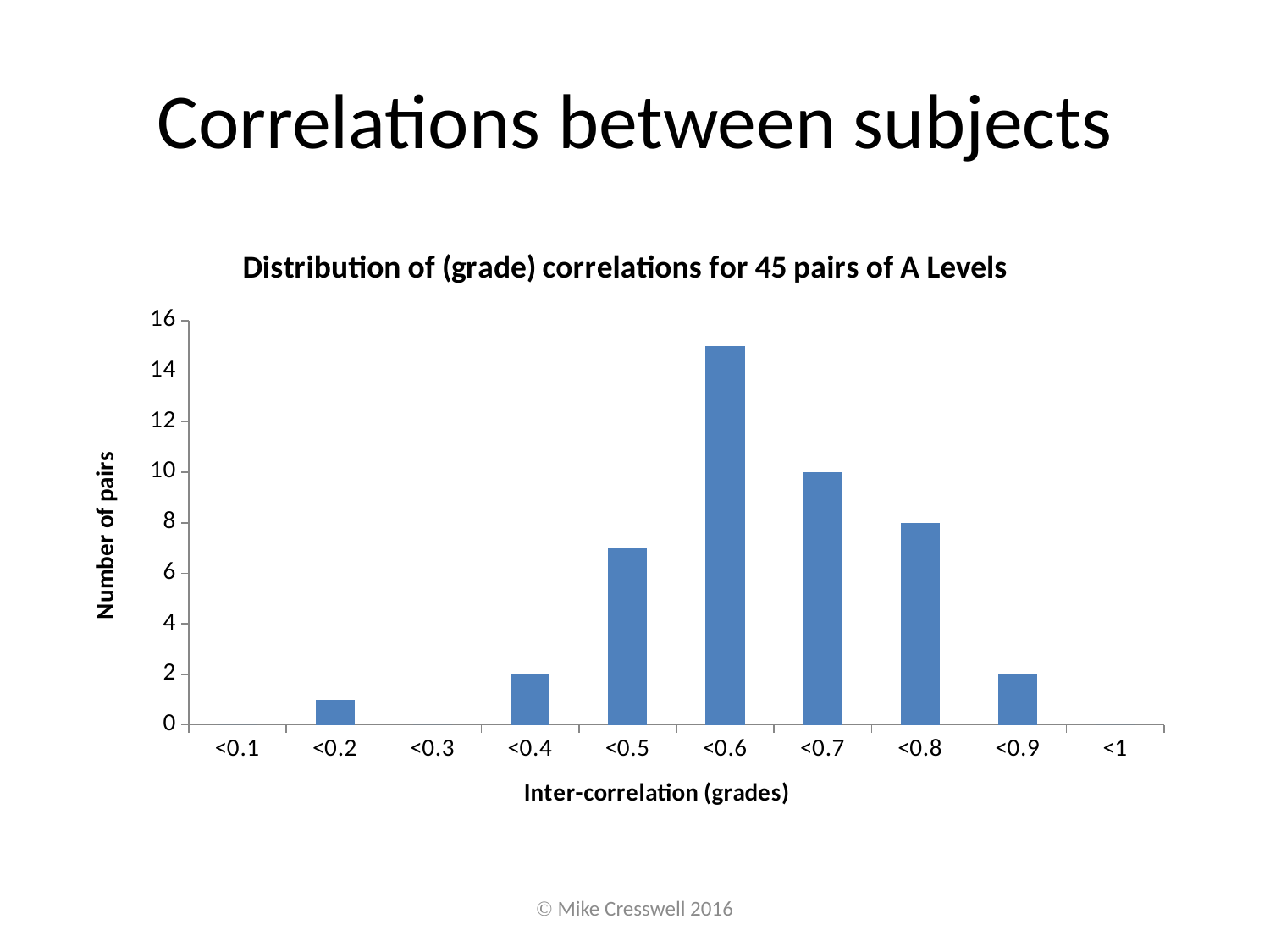
What is the difference in number of pairs between the <0.7 and <0.8 categories? 2 Is the number of pairs for the <0.6 category greater or less than 14? greater What is the title of the chart? Distribution of (grade) correlations for 45 pairs of A Levels What is the number of pairs for the <0.3 category? 0 What is the number of pairs for the <0.4 category? 2 Which has more pairs, the <0.5 category or the <0.7 category? <0.7 What type of chart is shown on the slide? bar chart What is the number of pairs for the <0.8 category? 8 Is the number of pairs for the <0.5 category greater or less than 6? greater How many categories are shown on the x axis of the chart? 10 Which inter-correlation category has the highest number of pairs? <0.6 What is the number of pairs for the <0.7 category? 10